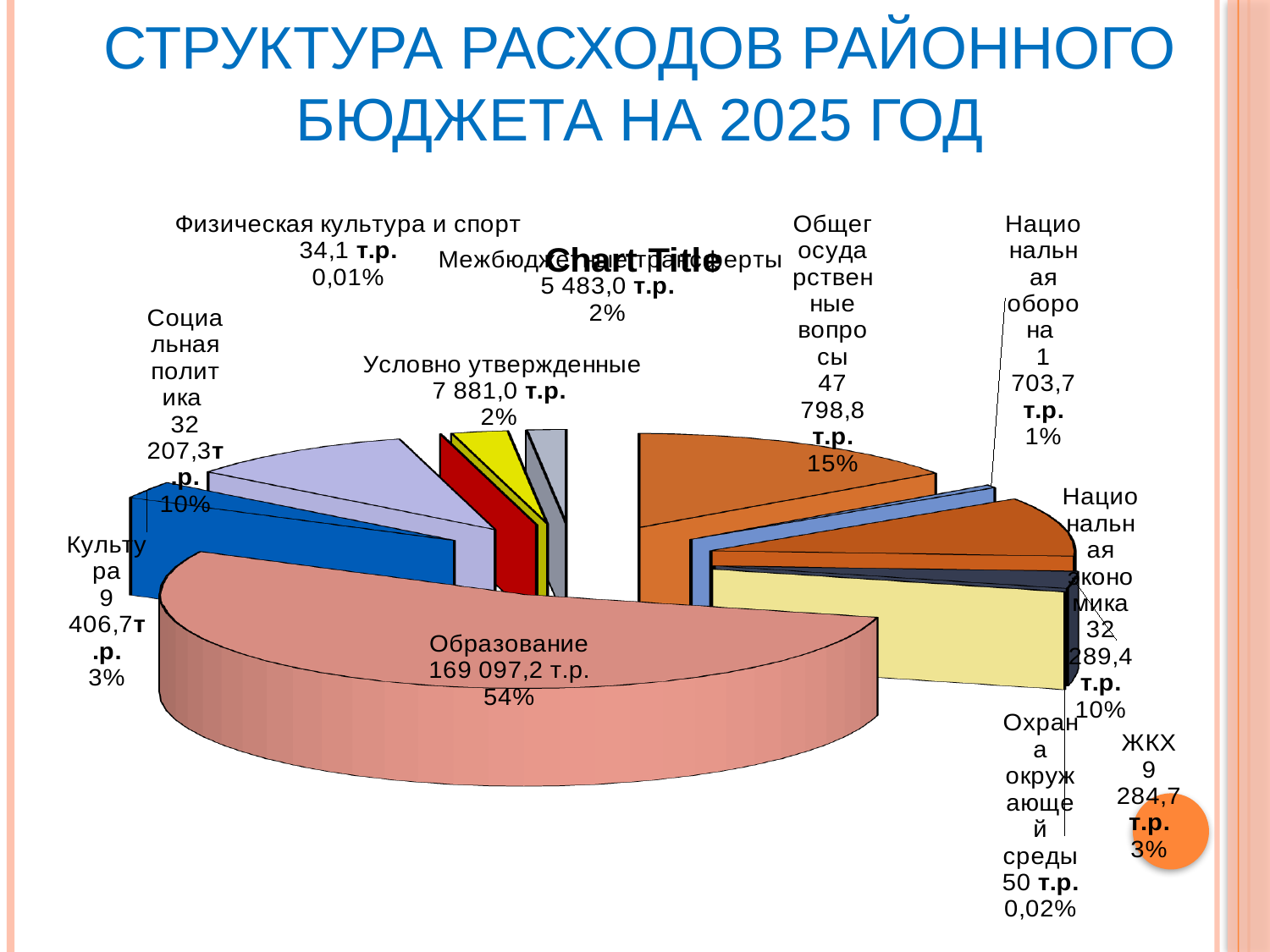
Which is larger, the value for Социальная политика or the value for Национальная экономика? Национальная экономика What share of the pie does Образование take? 54% Which category has the smallest value? Физическая культура и спорт What kind of chart is shown on the slide? pie chart What is the value for Образование? 169 097,2 т.р. What is the value for Общегосударственные вопросы? 47 798,8 т.р. What is the difference between the value for Культура and the value for ЖКХ? 122,0 т.р. What share of the pie does Общегосударственные вопросы take? 15% How many categories are shown in the pie chart? 11 What is the value for Национальная оборона? 1 703,7 т.р. Which category has the largest slice of the pie? Образование What share of the pie does Национальная экономика take? 10%